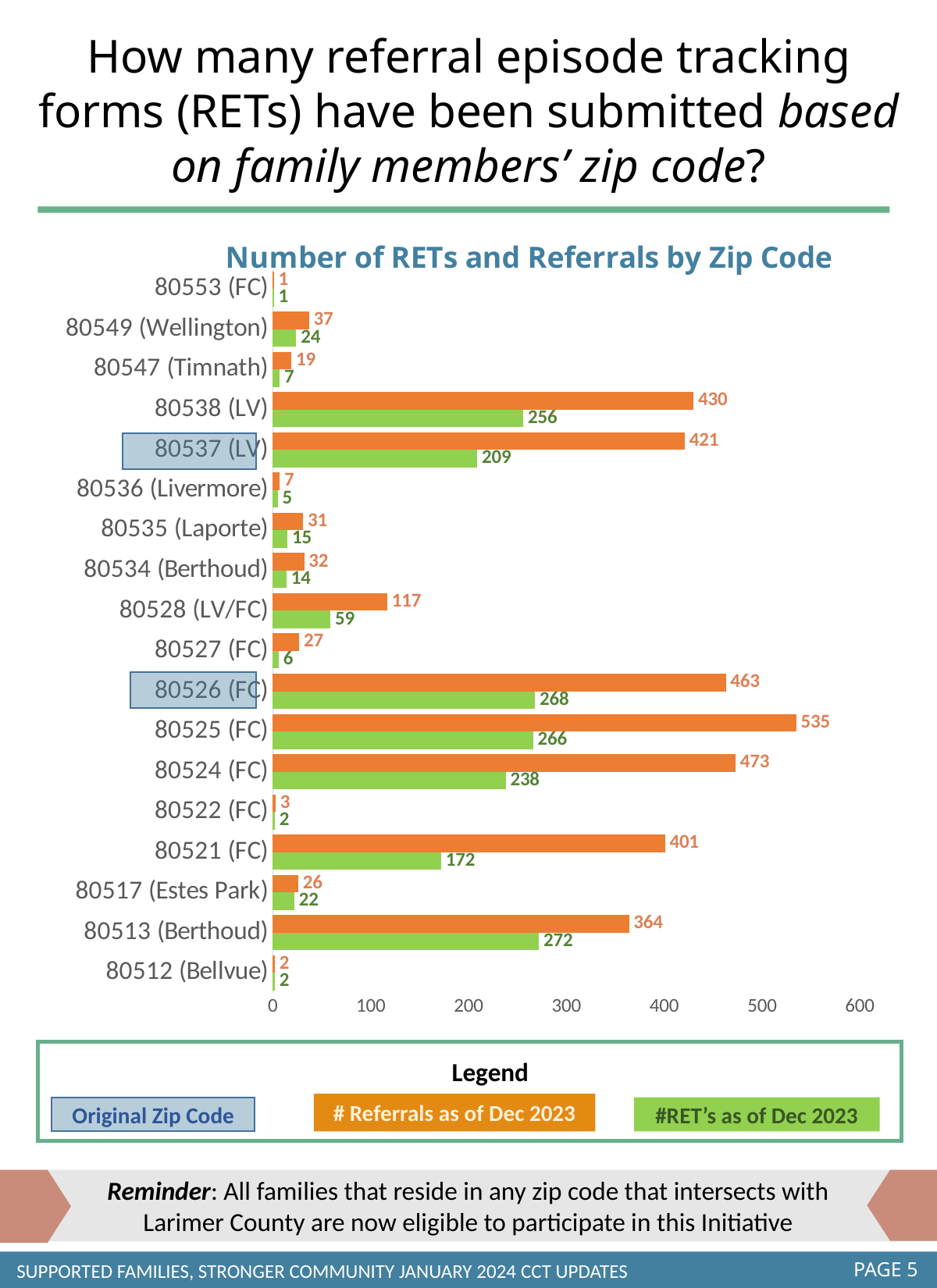
How many series does the legend list for the chart? 2 Which zip code has the highest number of referrals as of Dec 2023? 80525 (FC) What is the difference in referrals between 80524 (FC) and 80521 (FC)? 72 Which zip code has the highest number of RETs as of Dec 2023? 80513 (Berthoud) What is the number of referrals as of Dec 2023 for 80538 (LV)? 430 What kind of chart is shown on the slide? bar chart How many zip codes are plotted in the chart? 18 Which zip code has the lowest number of referrals as of Dec 2023? 80553 (FC) What is the number of RETs as of Dec 2023 for 80521 (FC)? 172 What is the difference between referrals and RETs for 80526 (FC)? 195 What is the title of the chart? Number of RETs and Referrals by Zip Code Which has more RETs as of Dec 2023, 80538 (LV) or 80537 (LV)? 80538 (LV)